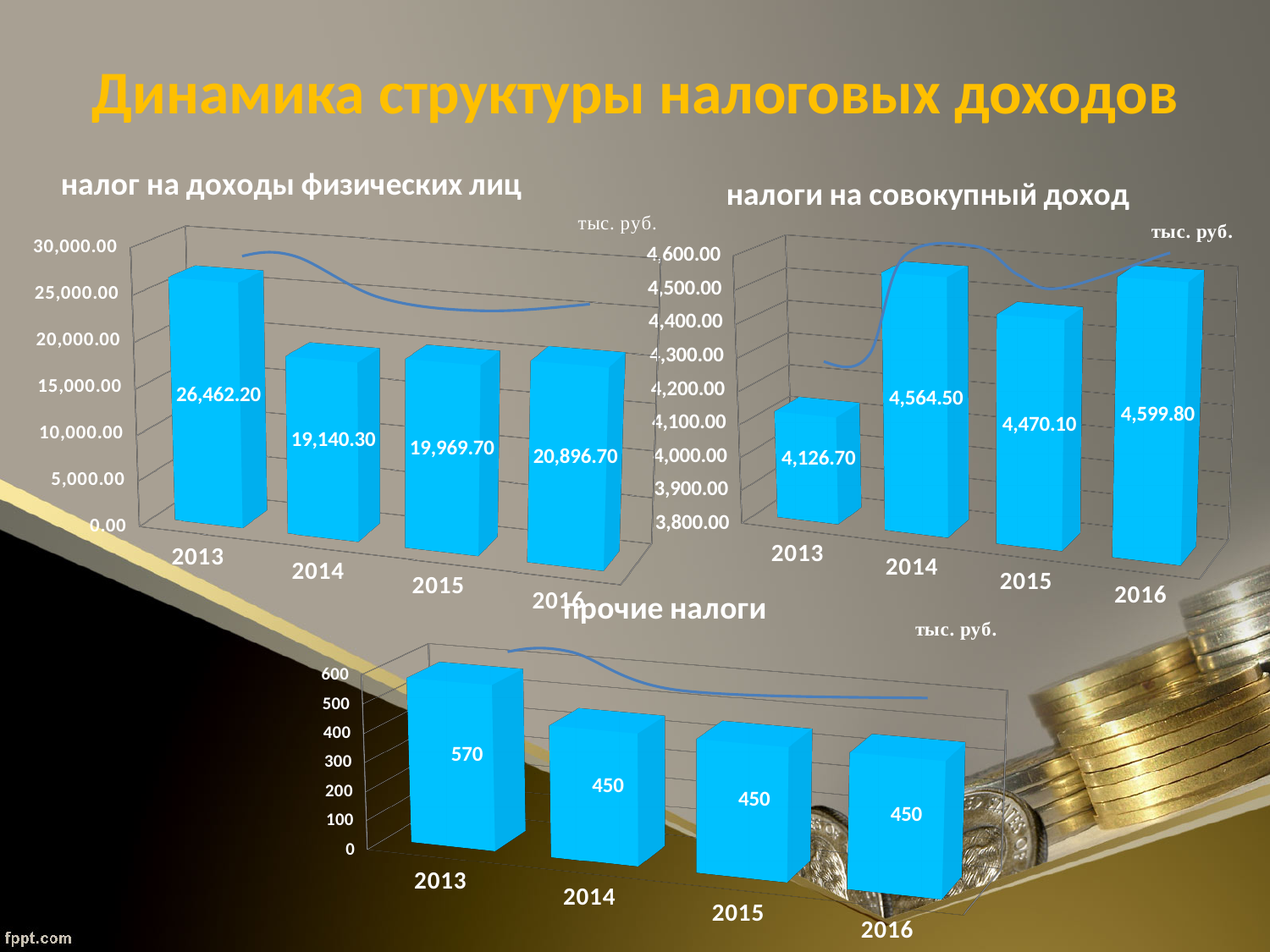
What unit is indicated next to the chart titled "налоги на совокупный доход"? тыс. руб. In the chart titled "налог на доходы физических лиц", what is the value for 2013? 26,462.20 In the chart titled "прочие налоги", what is the value for 2013? 570 How many years are shown on the x axis of the chart titled "прочие налоги"? 4 In the chart titled "налоги на совокупный доход", which year has the highest value? 2016 In the chart titled "прочие налоги", what is the difference between the 2013 value and the 2014 value? 120 In the chart titled "налоги на совокупный доход", which is larger, the value for 2014 or the value for 2015? 2014 In the chart titled "налоги на совокупный доход", what is the difference between the 2016 value and the 2013 value? 473.10 In the chart titled "налоги на совокупный доход", what is the value for 2015? 4,470.10 In the chart titled "налог на доходы физических лиц", which year has the lowest value? 2014 In the chart titled "налог на доходы физических лиц", what is the difference between the 2013 value and the 2014 value? 7,321.90 What kind of chart is the chart titled "налог на доходы физических лиц"? Bar chart